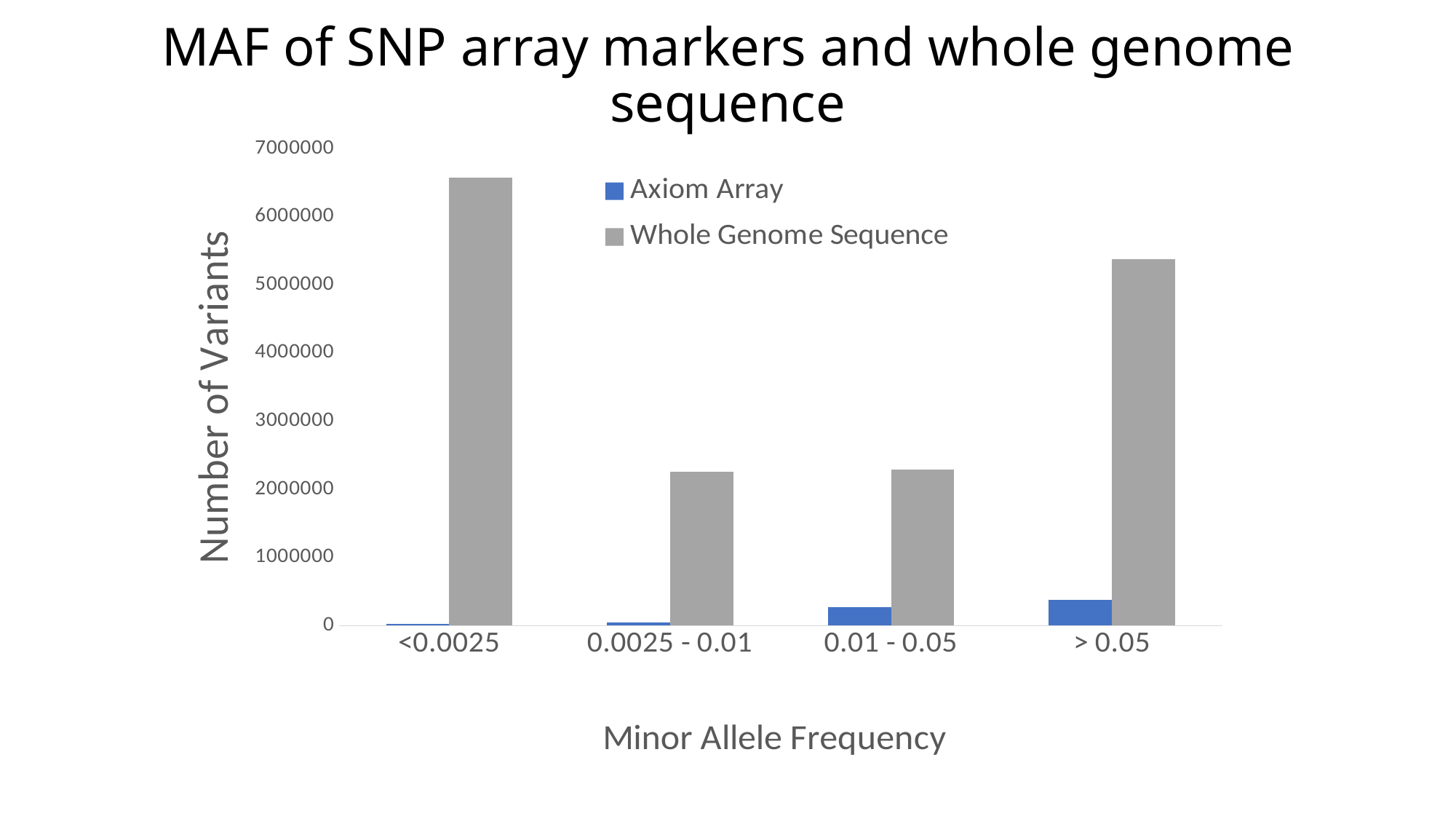
Is the Whole Genome Sequence value for > 0.05 greater or less than 5000000? greater How many Minor Allele Frequency categories are shown on the x axis? 4 What kind of chart is shown on the slide? bar chart What is the label of the y axis? Number of Variants Is the Axiom Array value for > 0.05 greater or less than 1000000? less What is the title of the chart? MAF of SNP array markers and whole genome sequence Which Minor Allele Frequency category has the lowest Axiom Array value? <0.0025 Which Minor Allele Frequency category has the highest Axiom Array value? > 0.05 How many series does the legend list? 2 Which is larger for the 0.01 - 0.05 category, the Axiom Array value or the Whole Genome Sequence value? Whole Genome Sequence Is the Whole Genome Sequence value for <0.0025 greater or less than 6000000? greater Which Minor Allele Frequency category has the highest Whole Genome Sequence value? <0.0025